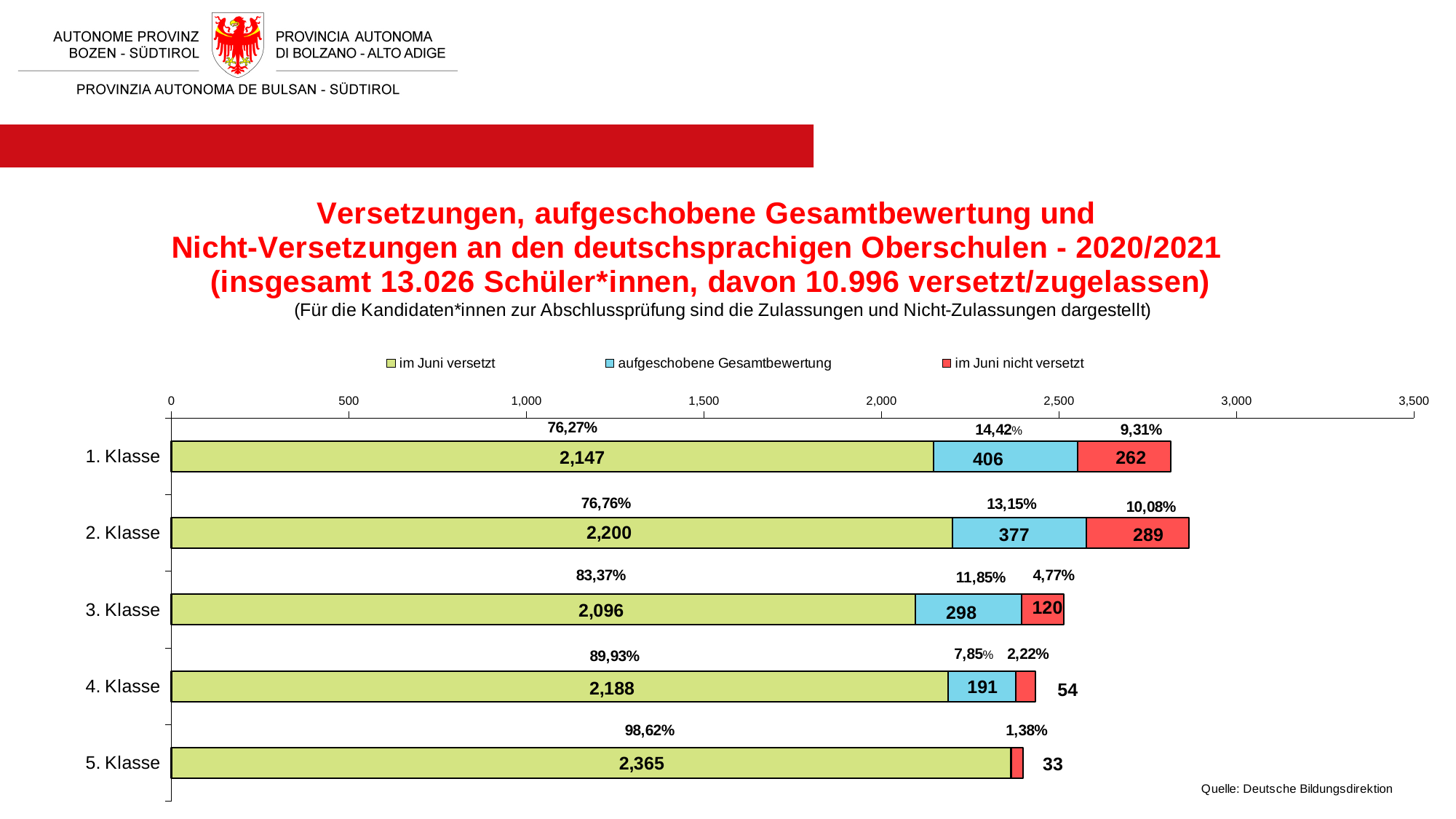
Which class has the highest number of students 'im Juni versetzt'? 5. Klasse What is the total of the stacked bar for 2. Klasse? 2,866 How many classes (categories) are shown on the chart? 5 How many series does the legend list? 3 How many students in 3. Klasse were 'im Juni nicht versetzt'? 120 Which class has the lowest number of students 'im Juni nicht versetzt'? 5. Klasse What percentage of 4. Klasse students were 'im Juni versetzt'? 89,93% What is the value for 'aufgeschobene Gesamtbewertung' in 2. Klasse? 377 What type of chart is shown on the slide? Stacked bar chart What is the difference between the 'im Juni nicht versetzt' values for 2. Klasse and 1. Klasse? 27 How many students in 1. Klasse were 'im Juni versetzt'? 2,147 Which is larger: the 'aufgeschobene Gesamtbewertung' value for 1. Klasse or for 3. Klasse? 1. Klasse